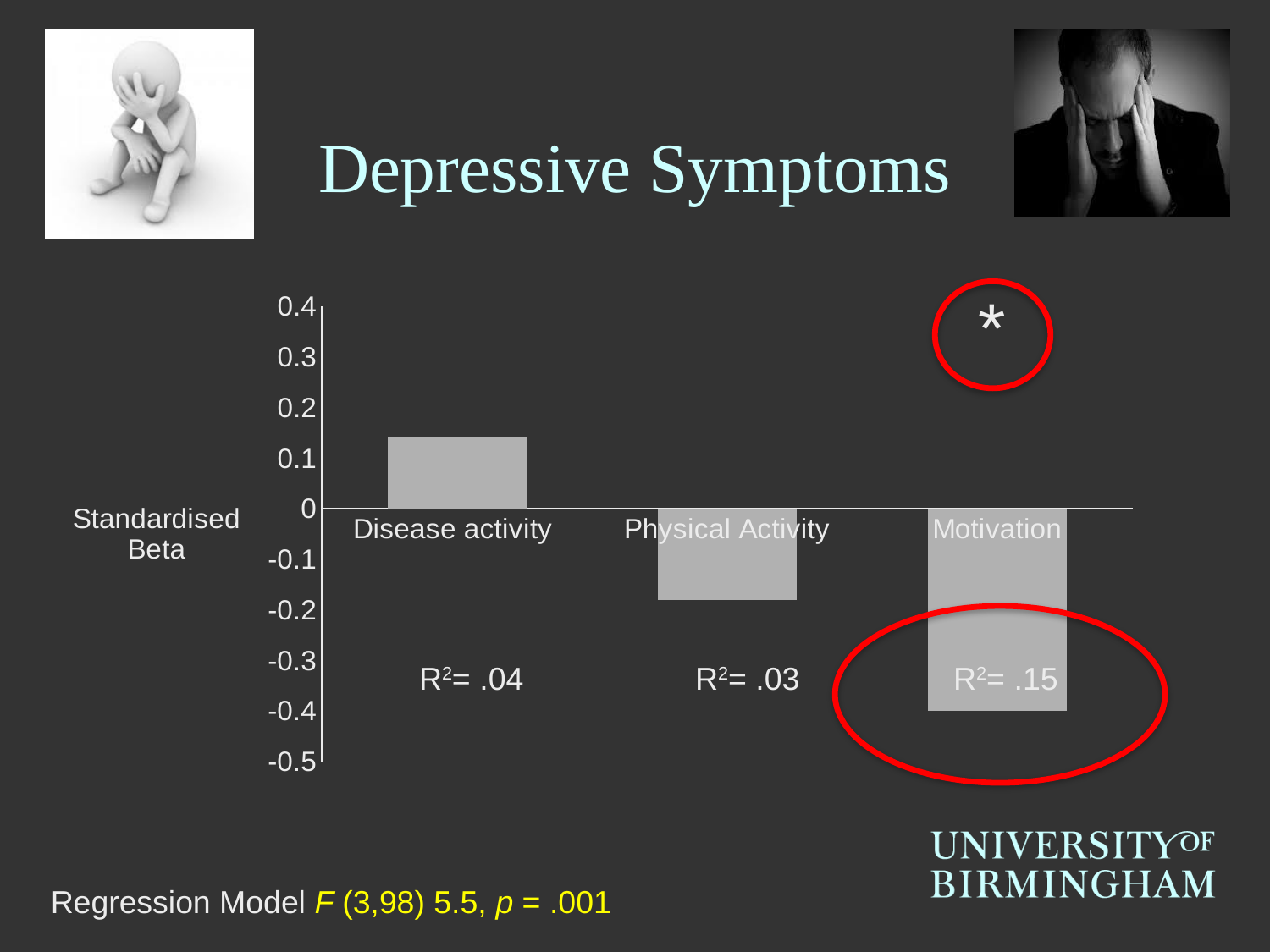
What R² value is printed for Physical Activity? .03 What kind of chart is shown on the slide? bar chart Which category has the lowest standardised beta? Motivation Is the standardised beta for Disease activity greater or less than 0.1? greater How many categories are plotted in the chart? 3 What R² value is printed for Motivation? .15 What is the label on the vertical axis of the chart? Standardised Beta Is the standardised beta for Physical Activity greater or less than -0.1? less Which has the lower standardised beta, Physical Activity or Motivation? Motivation Which category has the highest standardised beta? Disease activity What R² value is printed for Disease activity? .04